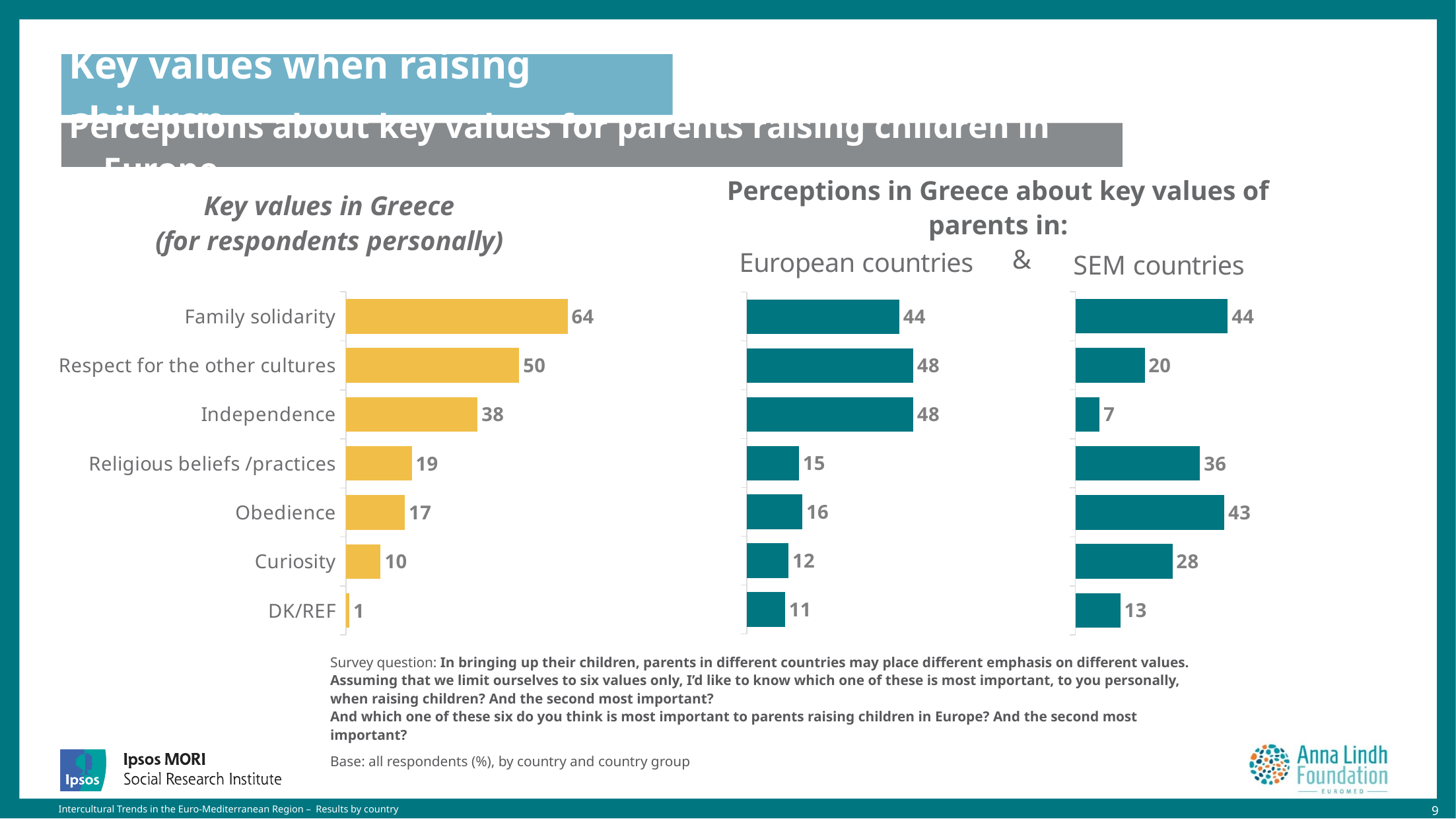
In the 'Key values in Greece (for respondents personally)' chart, which category has the lowest value? DK/REF How many categories are shown in the 'Key values in Greece (for respondents personally)' chart? 7 In the 'Key values in Greece (for respondents personally)' chart, what is the value for Family solidarity? 64 In the 'European countries' chart, what is the value for Religious beliefs /practices? 15 What colour are the bars in the 'Key values in Greece (for respondents personally)' chart? Yellow In the 'European countries' chart, which is larger, Obedience or Curiosity? Obedience In the 'SEM countries' chart, which category has the highest value? Family solidarity In the 'Key values in Greece (for respondents personally)' chart, what is the difference between Respect for the other cultures and Independence? 12 What type of chart is the 'Key values in Greece (for respondents personally)' chart? Bar chart